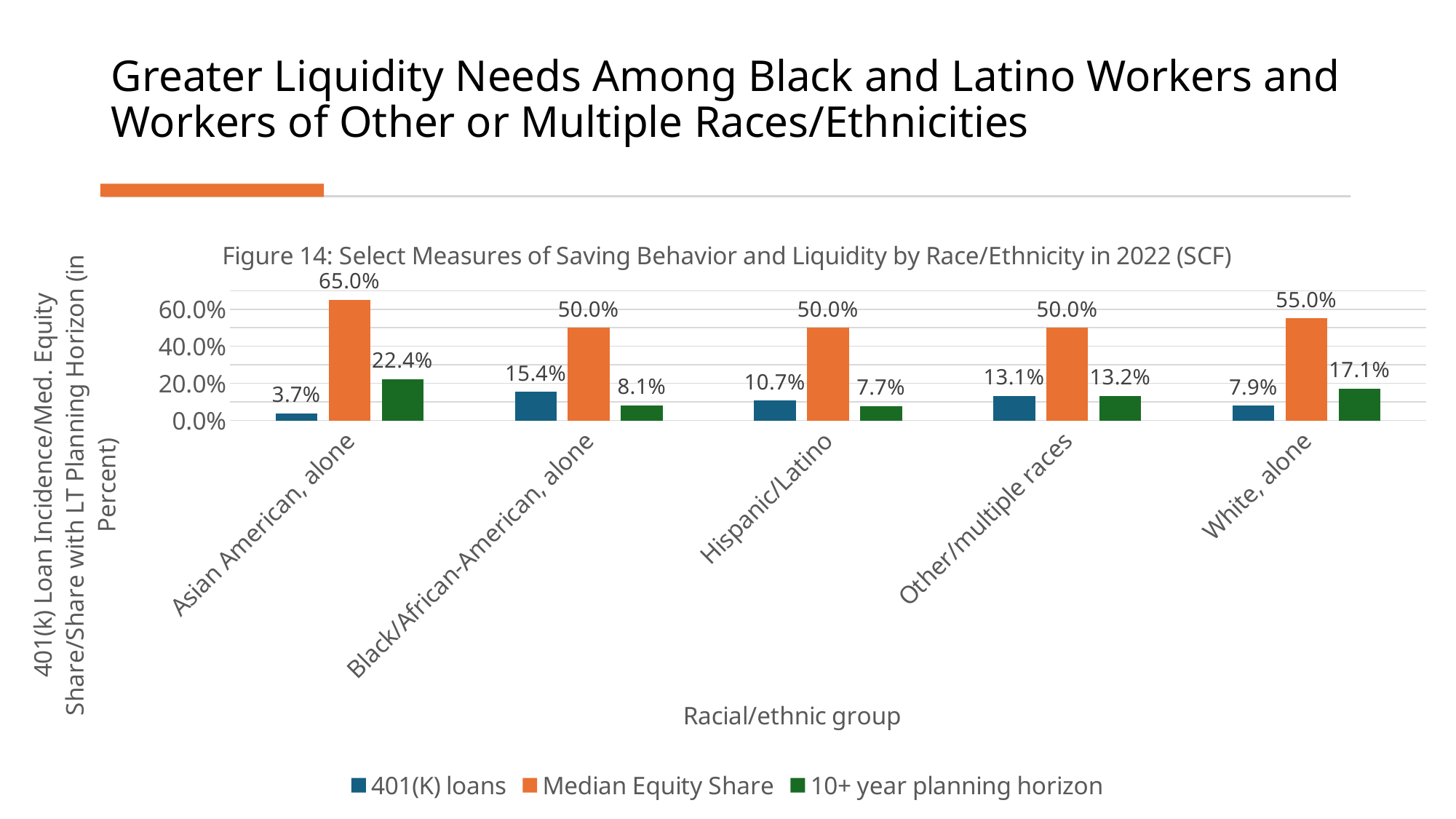
How many series does the legend list? 3 Which is larger for Hispanic/Latino: the 401(K) loans value or the 10+ year planning horizon value? 401(K) loans Which racial/ethnic group has the lowest 401(K) loans value? Asian American, alone What is the difference between the 10+ year planning horizon values for Asian American, alone and White, alone? 5.3% Which racial/ethnic group has the lowest 10+ year planning horizon value? Hispanic/Latino What is the 10+ year planning horizon value for Asian American, alone? 22.4% How many racial/ethnic groups are shown on the x axis? 5 Which racial/ethnic group has the highest Median Equity Share? Asian American, alone What is the Median Equity Share for White, alone? 55.0% What is the 401(K) loans value for Black/African-American, alone? 15.4% What kind of chart is shown on the slide? Bar chart What is the title of the chart? Figure 14: Select Measures of Saving Behavior and Liquidity by Race/Ethnicity in 2022 (SCF)